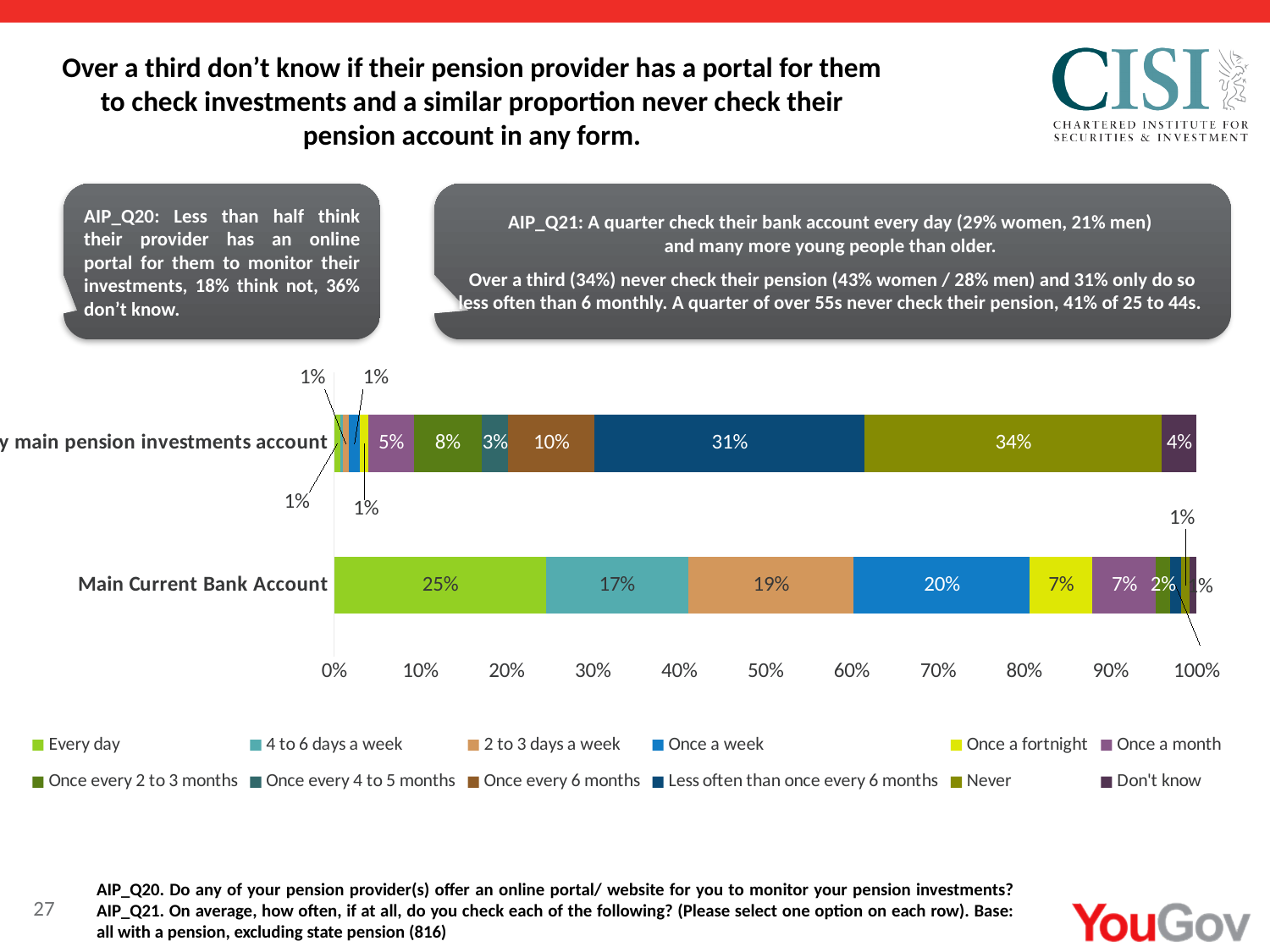
What kind of chart is shown on the slide? Stacked bar chart What percentage of respondents never check their main pension investments account? 34% What is the difference in percentage points between 'Never' and 'Less often than once every 6 months' for the main pension investments account? 3 percentage points Which is larger: the share checking their Main Current Bank Account every day or the share checking their main pension investments account every day? Main Current Bank Account What percentage check their main pension investments account once every 6 months? 10% What percentage check their Main Current Bank Account once a week? 20% How many account categories are plotted in the chart? 2 What percentage answered 'Don't know' for the main pension investments account? 4% What percentage check their Main Current Bank Account every day? 25% How many series does the legend list? 12 What is the difference in percentage points between 'Every day' and '4 to 6 days a week' for the Main Current Bank Account? 8 percentage points What percentage check their main pension investments account less often than once every 6 months? 31%